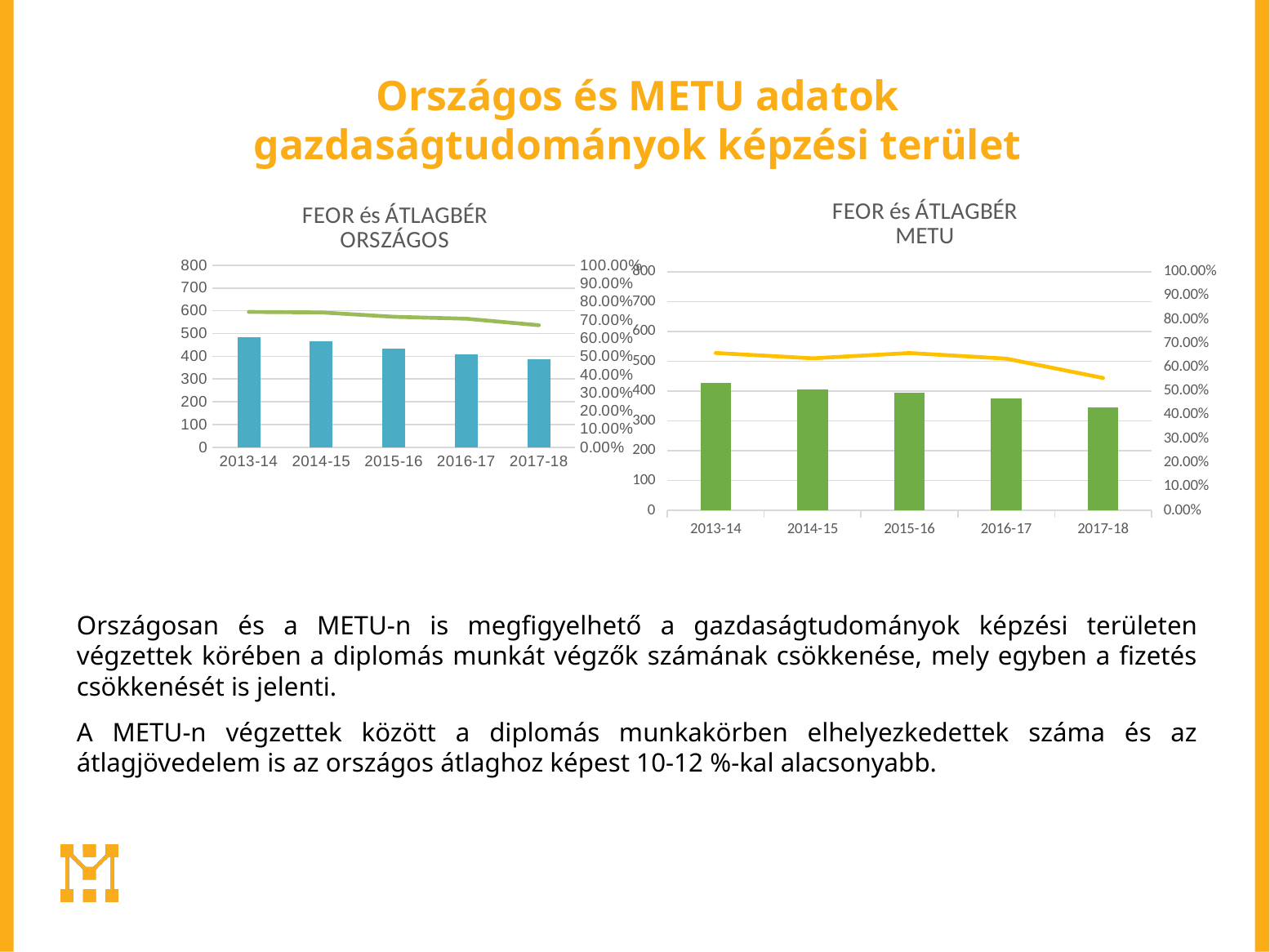
In the chart titled 'FEOR és ÁTLAGBÉR METU', which bar is taller, 2014-15 or 2017-18? 2014-15 What colour are the bars in the chart titled 'FEOR és ÁTLAGBÉR METU'? Green In the chart titled 'FEOR és ÁTLAGBÉR METU', which year has the tallest bar? 2013-14 In the chart titled 'FEOR és ÁTLAGBÉR ORSZÁGOS', is the bar value for 2013-14 greater or less than 400? greater In the chart titled 'FEOR és ÁTLAGBÉR ORSZÁGOS', which year has the shortest bar? 2017-18 In the chart titled 'FEOR és ÁTLAGBÉR METU', which year has the shortest bar? 2017-18 In the chart titled 'FEOR és ÁTLAGBÉR ORSZÁGOS', what kind of chart is used for the yearly values? Bar chart with a line In the chart titled 'FEOR és ÁTLAGBÉR ORSZÁGOS', do the bar values rise or fall from 2013-14 to 2017-18? Fall In the chart titled 'FEOR és ÁTLAGBÉR ORSZÁGOS', which year has the tallest bar? 2013-14 In the chart titled 'FEOR és ÁTLAGBÉR METU', is the bar value for 2013-14 greater or less than 300? greater In the chart titled 'FEOR és ÁTLAGBÉR ORSZÁGOS', how many academic years are shown on the x axis? 5